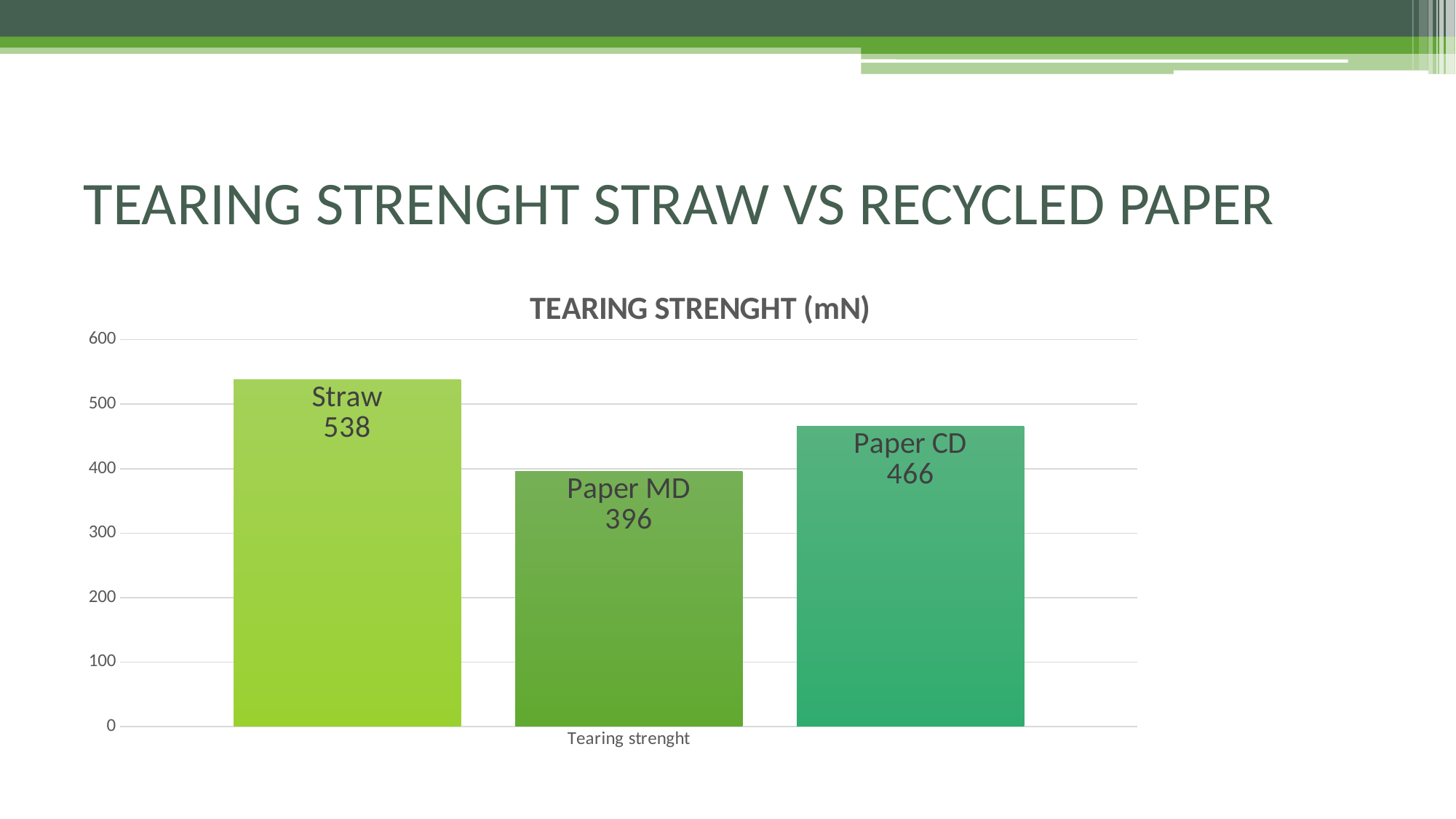
Which has a larger tearing strength, Paper CD or Paper MD? Paper CD What kind of chart is shown on the slide? Bar chart What is the tearing strength value for Straw? 538 How many bars are shown in the chart? 3 What is the tearing strength value for Paper CD? 466 What is the tearing strength value for Paper MD? 396 What is the difference in tearing strength between Straw and Paper MD? 142 What is the title of the chart? TEARING STRENGHT (mN) Which material has the highest tearing strength? Straw What is the difference in tearing strength between Paper CD and Paper MD? 70 Is the tearing strength for Straw greater or less than 500? greater Which material has the lowest tearing strength? Paper MD